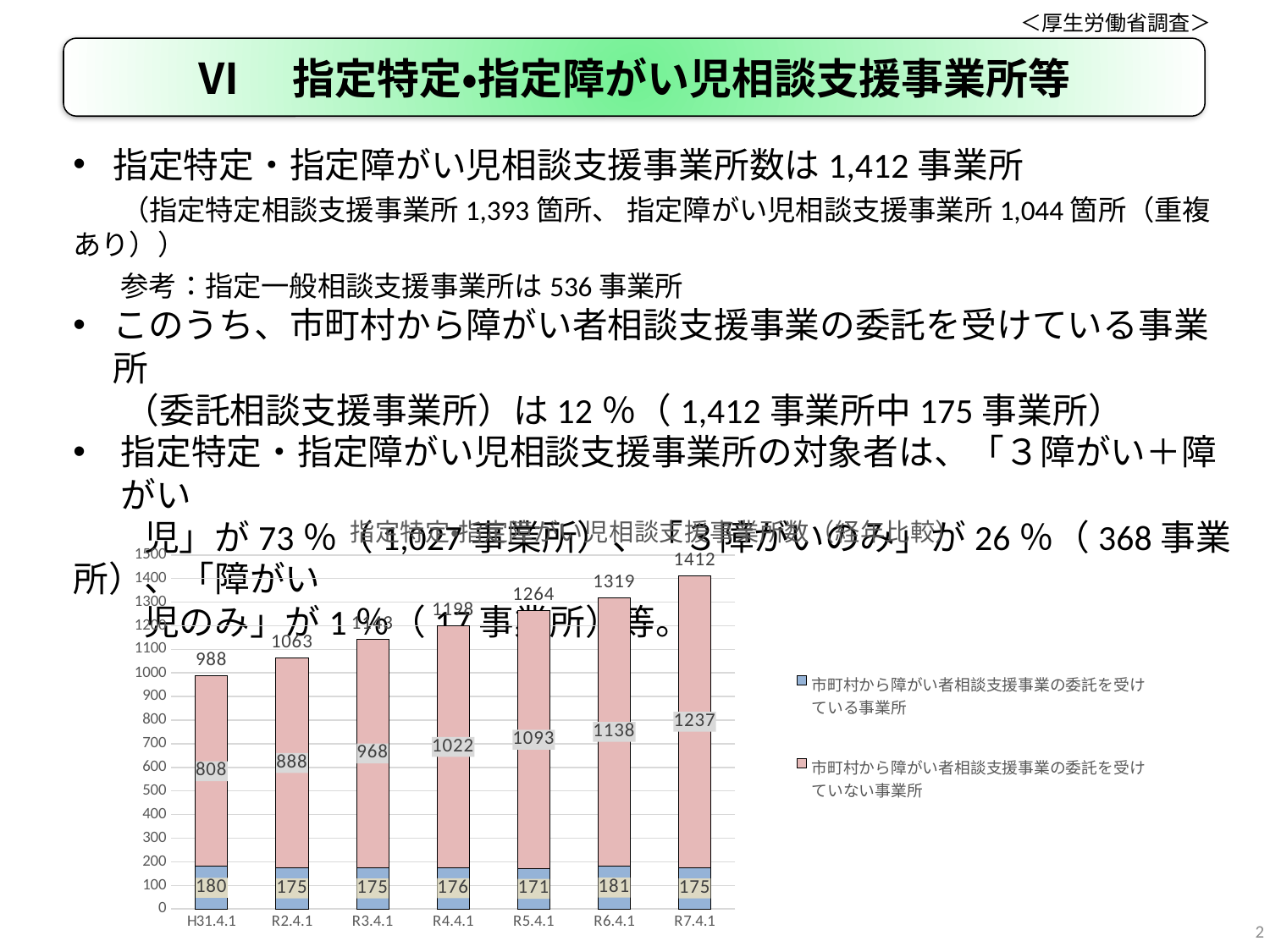
Do the total values rise or fall from H31.4.1 to R7.4.1? rise What is the value for 市町村から障がい者相談支援事業の委託を受けている事業所 at H31.4.1? 180 Is the value for 市町村から障がい者相談支援事業の委託を受けていない事業所 larger at R6.4.1 or at R4.4.1? R6.4.1 What is the difference between the total for R7.4.1 and the total for H31.4.1? 424 Which colour represents 市町村から障がい者相談支援事業の委託を受けている事業所 in the chart? blue What is the total number of 事業所 shown above the bar for R7.4.1? 1412 Which time point has the highest total number of 事業所? R7.4.1 Which time point has the lowest value for 市町村から障がい者相談支援事業の委託を受けている事業所? R5.4.1 How many series does the chart legend list? 2 What is the value for 市町村から障がい者相談支援事業の委託を受けていない事業所 at R5.4.1? 1093 What kind of chart is shown on the slide? stacked bar chart How many time points (categories) are shown on the x axis of the chart? 7